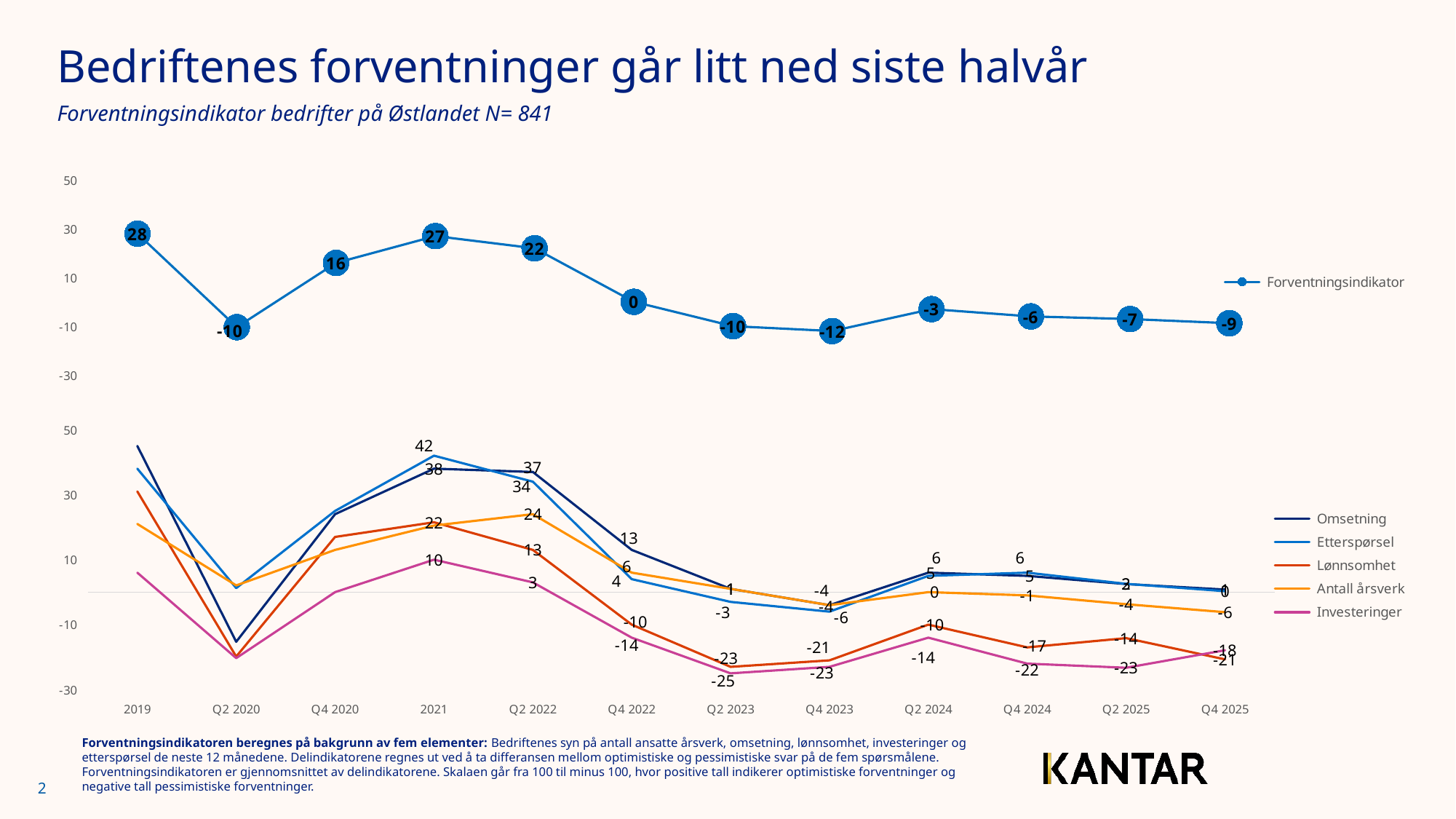
In the top chart, what is the value of the Forventningsindikator for Q4 2025? -9 How many series does the legend of the bottom chart list? 5 In the top chart, what is the difference between the Forventningsindikator values for 2021 and Q2 2022? 5 In the bottom chart, what is the value of Etterspørsel for 2021? 42 In the top chart, what is the Forventningsindikator value for Q4 2022? 0 In the top chart, is the Forventningsindikator value for Q2 2025 higher or lower than for Q2 2024? lower In the top chart, which period has the lowest Forventningsindikator value? Q4 2023 What type of chart is the bottom chart? line chart In the top chart, what is the value of the Forventningsindikator for 2019? 28 In the top chart, which period has the highest Forventningsindikator value? 2019 In the bottom chart, what is the value of Investeringer for Q2 2023? -25 In the top chart, how many data points does the Forventningsindikator line have? 12